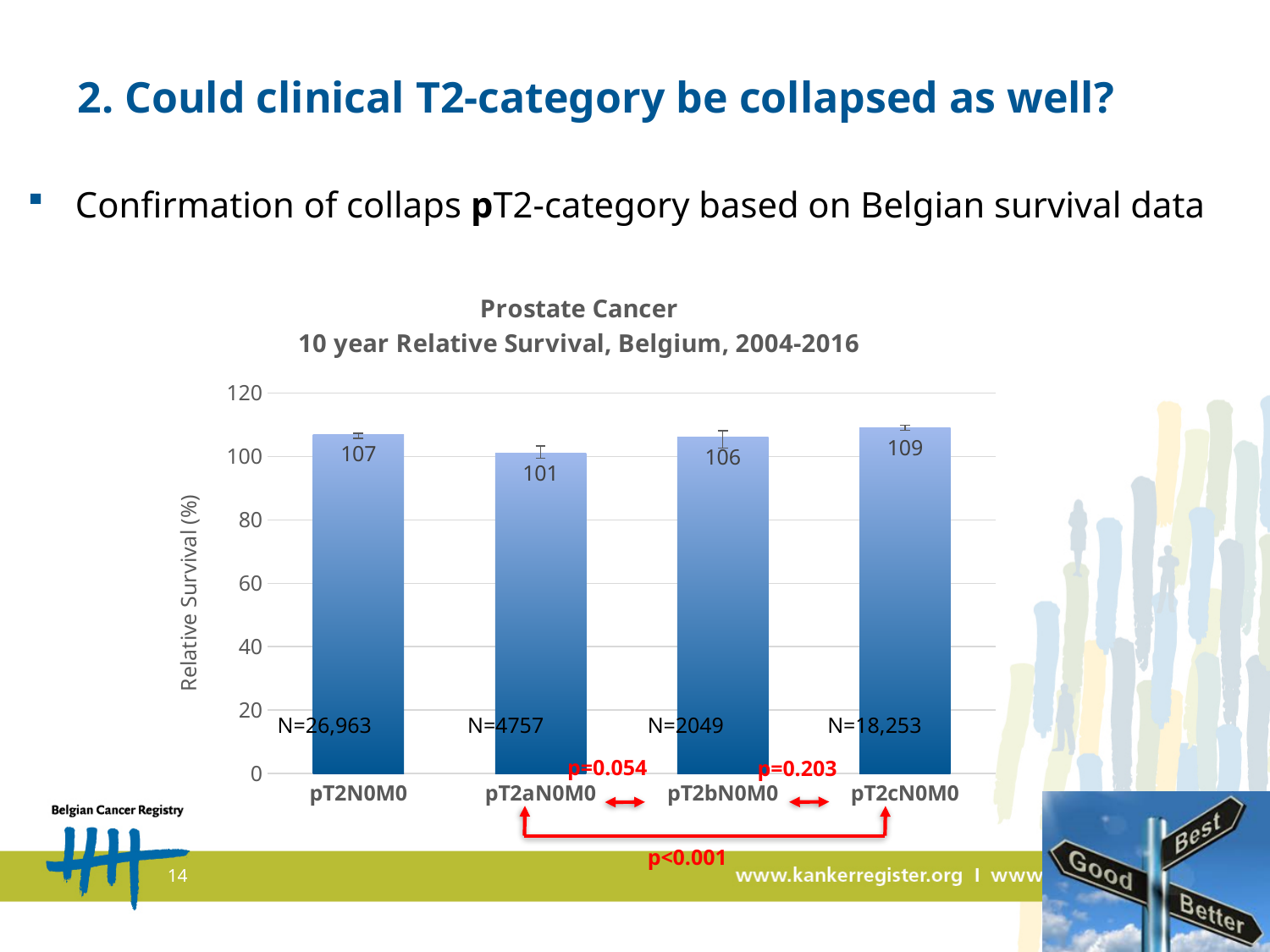
What is the 10 year relative survival value for pT2cN0M0? 109 What is the 10 year relative survival value for pT2bN0M0? 106 What is the 10 year relative survival value for pT2aN0M0? 101 How many categories are shown on the x axis? 4 Which has a larger relative survival value, pT2N0M0 or pT2aN0M0? pT2N0M0 What is the 10 year relative survival value for pT2N0M0? 107 What is the difference between the relative survival values for pT2cN0M0 and pT2aN0M0? 8 What is the N value shown for the pT2N0M0 bar? N=26,963 Which category has the lowest relative survival value? pT2aN0M0 What type of chart is shown on the slide? Bar chart What is the label of the y axis? Relative Survival (%) Which category has the highest relative survival value? pT2cN0M0